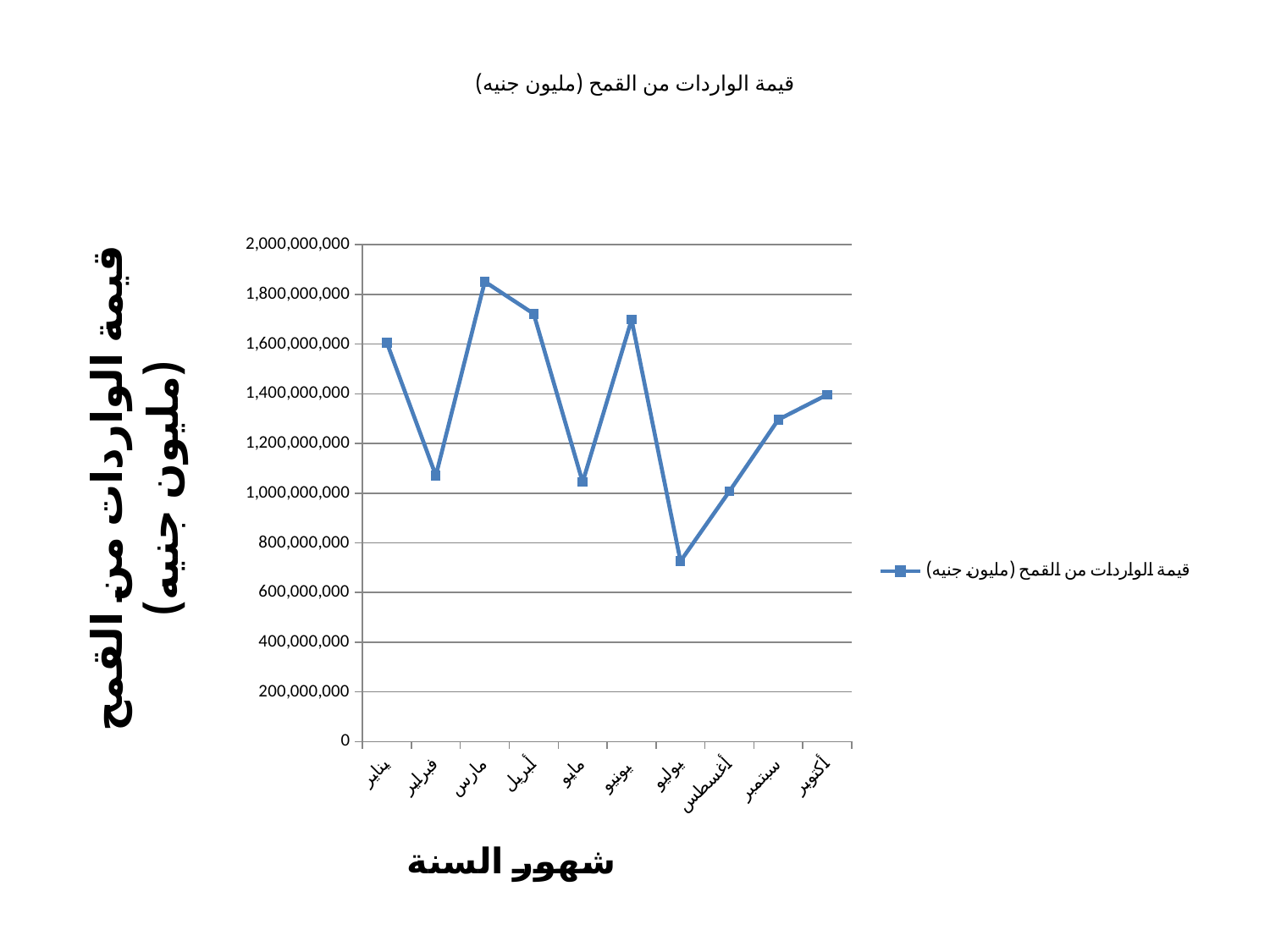
What is the title of the chart? قيمة الواردات من القمح (مليون جنيه) Which month has the highest value of wheat imports? مارس Is the value for مارس greater or less than 1,800,000,000? greater What kind of chart is shown on the slide? line chart Do the values rise or fall from يوليو to أكتوبر? rise How many months are plotted along the x axis? 10 How many series does the legend list? 1 Is the value for سبتمبر greater or less than 1,200,000,000? greater Is the value for يوليو greater or less than 800,000,000? less Which month has the lowest value of wheat imports? يوليو Which is larger, the value for مارس or the value for أبريل? مارس